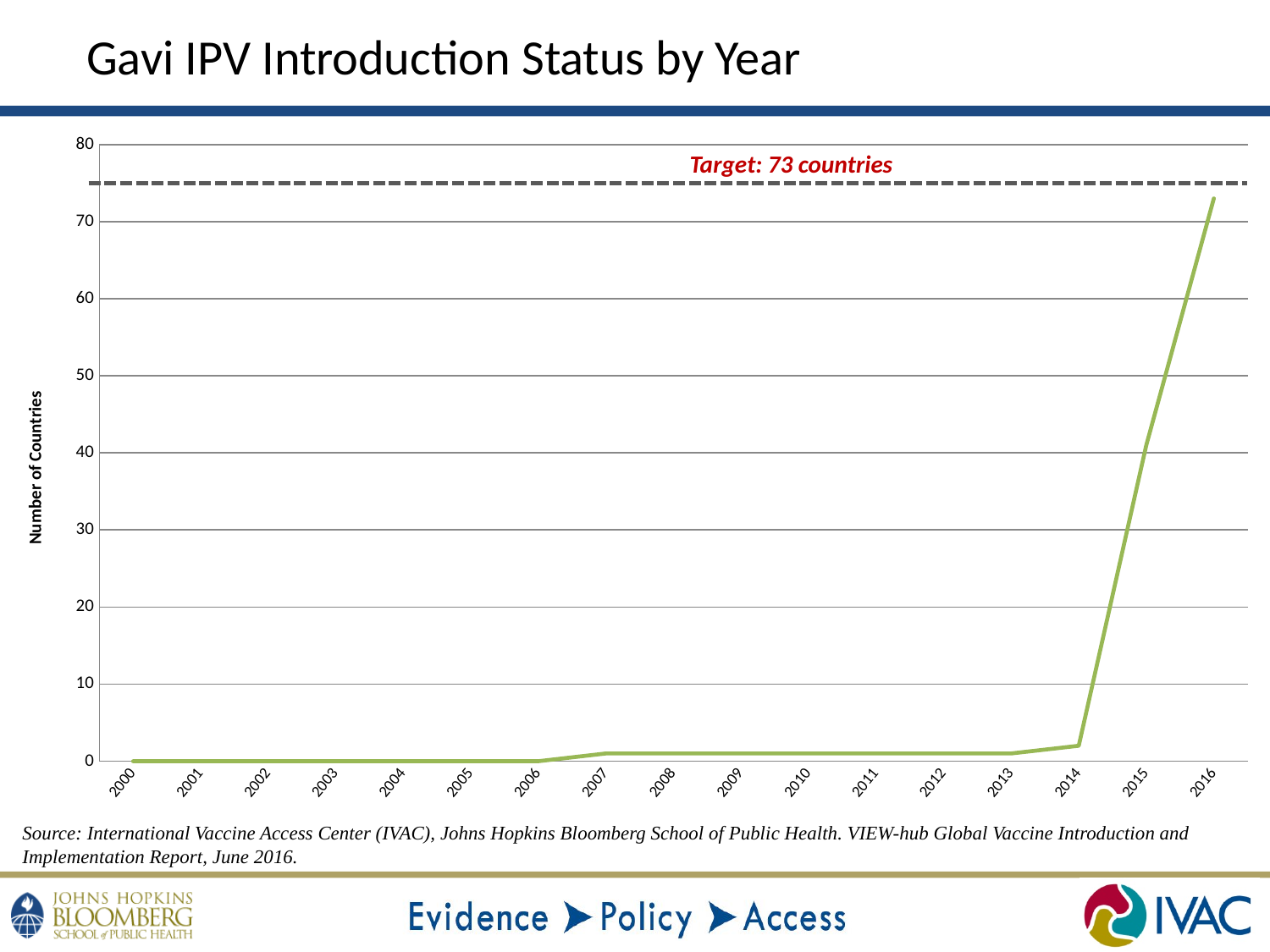
What kind of chart is shown on the slide? line chart How many years are plotted along the x axis? 17 Which year has the larger value, 2015 or 2016? 2016 Do the values rise or fall from 2014 to 2016? rise Is the value for 2016 greater or less than 70? greater Is the value for 2015 greater or less than 50? less Is the value for 2015 greater or less than 30? greater What is the label of the y axis? Number of Countries What target is marked by the dashed line on the chart? 73 countries Which year has the highest number of countries? 2016 What is the number of countries for 2000? 0